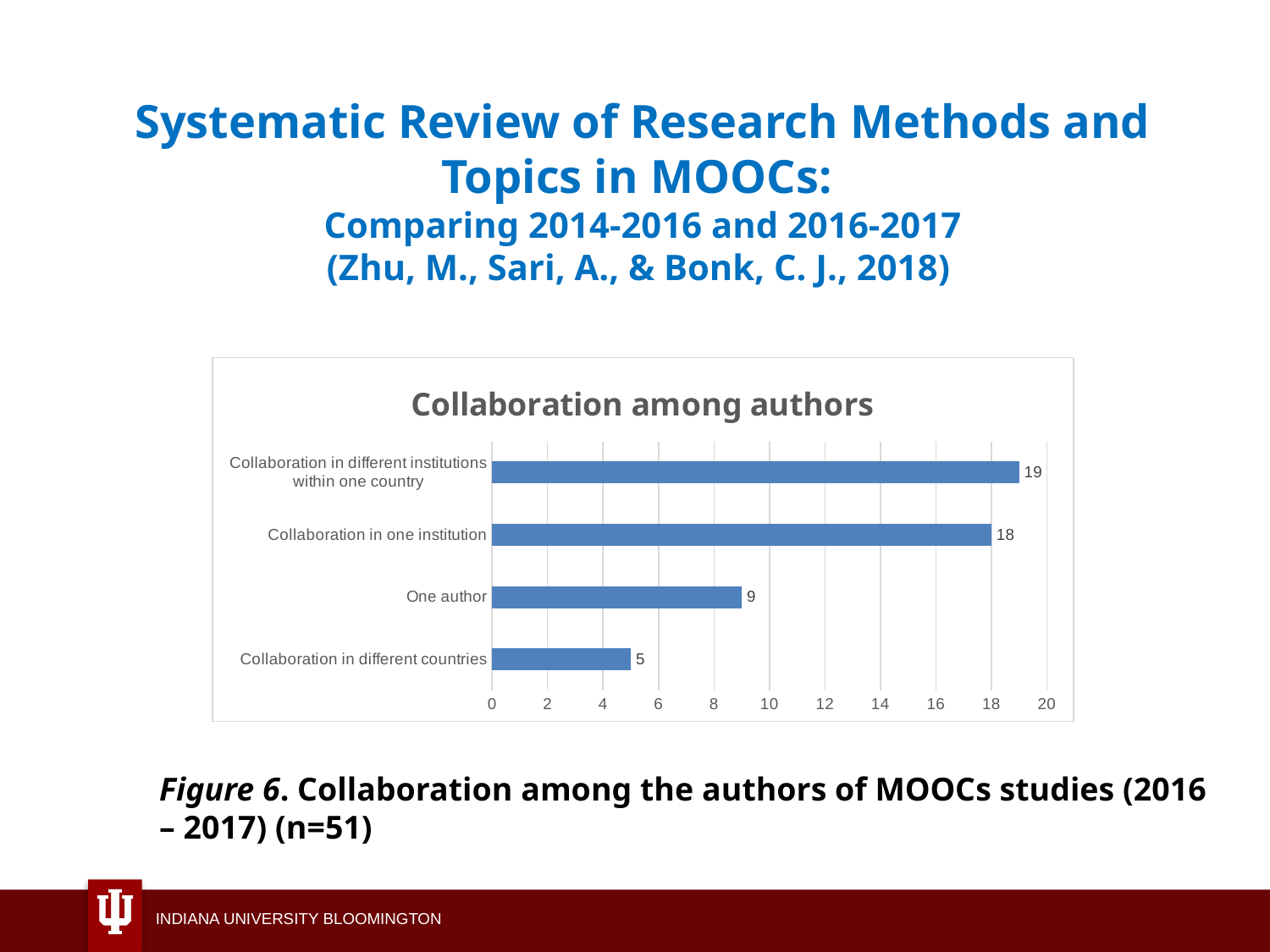
What is the difference between the values for "Collaboration in one institution" and "One author"? 9 How many categories are shown in the chart? 4 What is the value for "One author"? 9 What is the value for "Collaboration in different institutions within one country"? 19 What is the title of the chart? Collaboration among authors What kind of chart is shown on the slide? Bar chart What is the value for "Collaboration in one institution"? 18 Which category has the lowest value? Collaboration in different countries Which category has the highest value? Collaboration in different institutions within one country Which is larger: the value for "One author" or the value for "Collaboration in different countries"? One author Is the value for "Collaboration in one institution" greater or less than 10? greater What is the value for "Collaboration in different countries"? 5